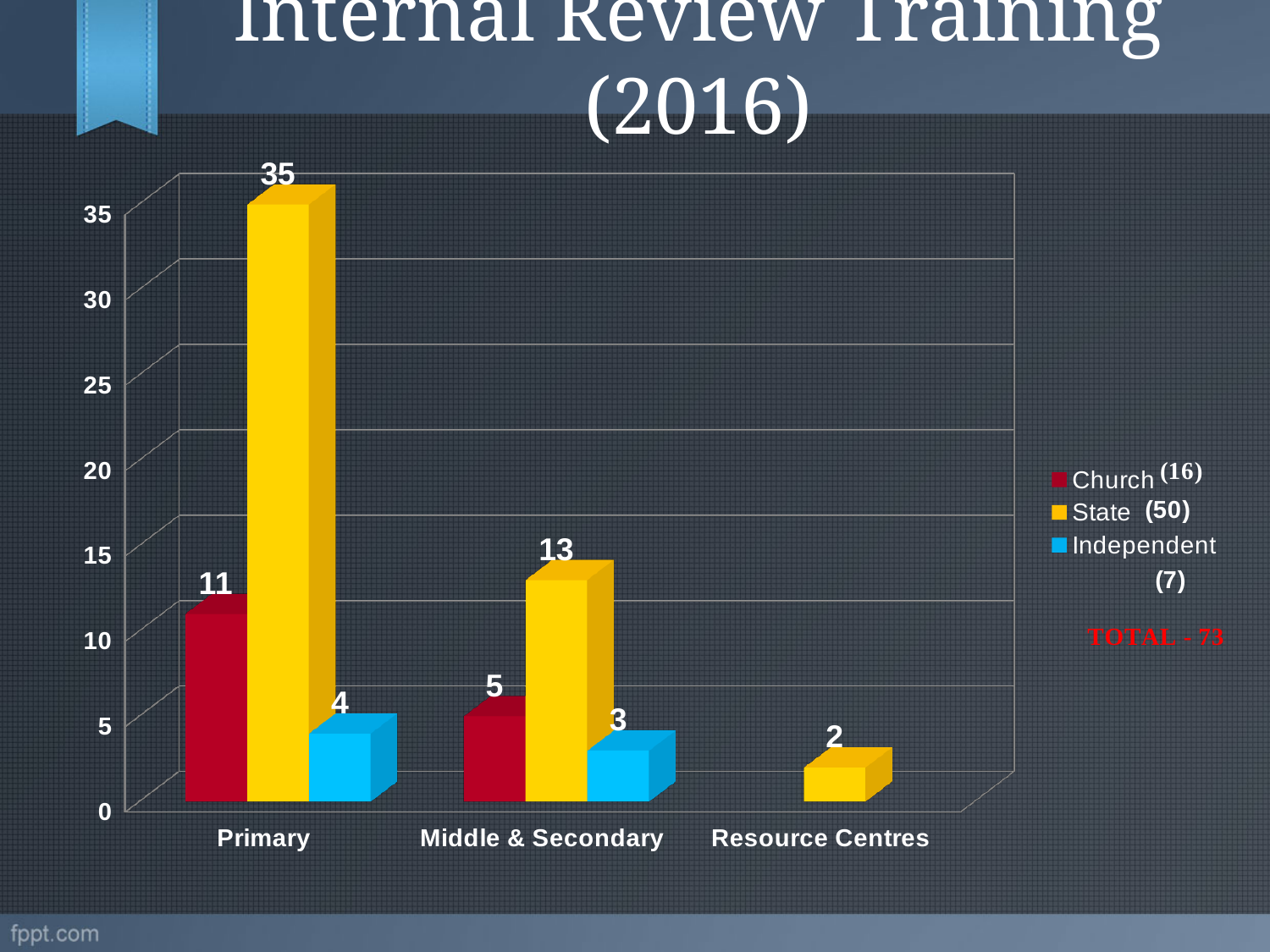
How many categories are shown on the x axis? 3 What is the value for State in the Resource Centres category? 2 Which series has the lowest value in the Primary category? Independent What total is stated on the slide next to the legend? TOTAL - 73 Which series has the highest value in the Middle & Secondary category? State What is the difference between the State and Church values in the Primary category? 24 What is the value for State in the Primary category? 35 What is the value for Church in the Middle & Secondary category? 5 Which is larger: Church in Primary or State in Middle & Secondary? State in Middle & Secondary What kind of chart is shown on the slide? Bar chart How many series does the legend list? 3 What is the value for Independent in the Primary category? 4